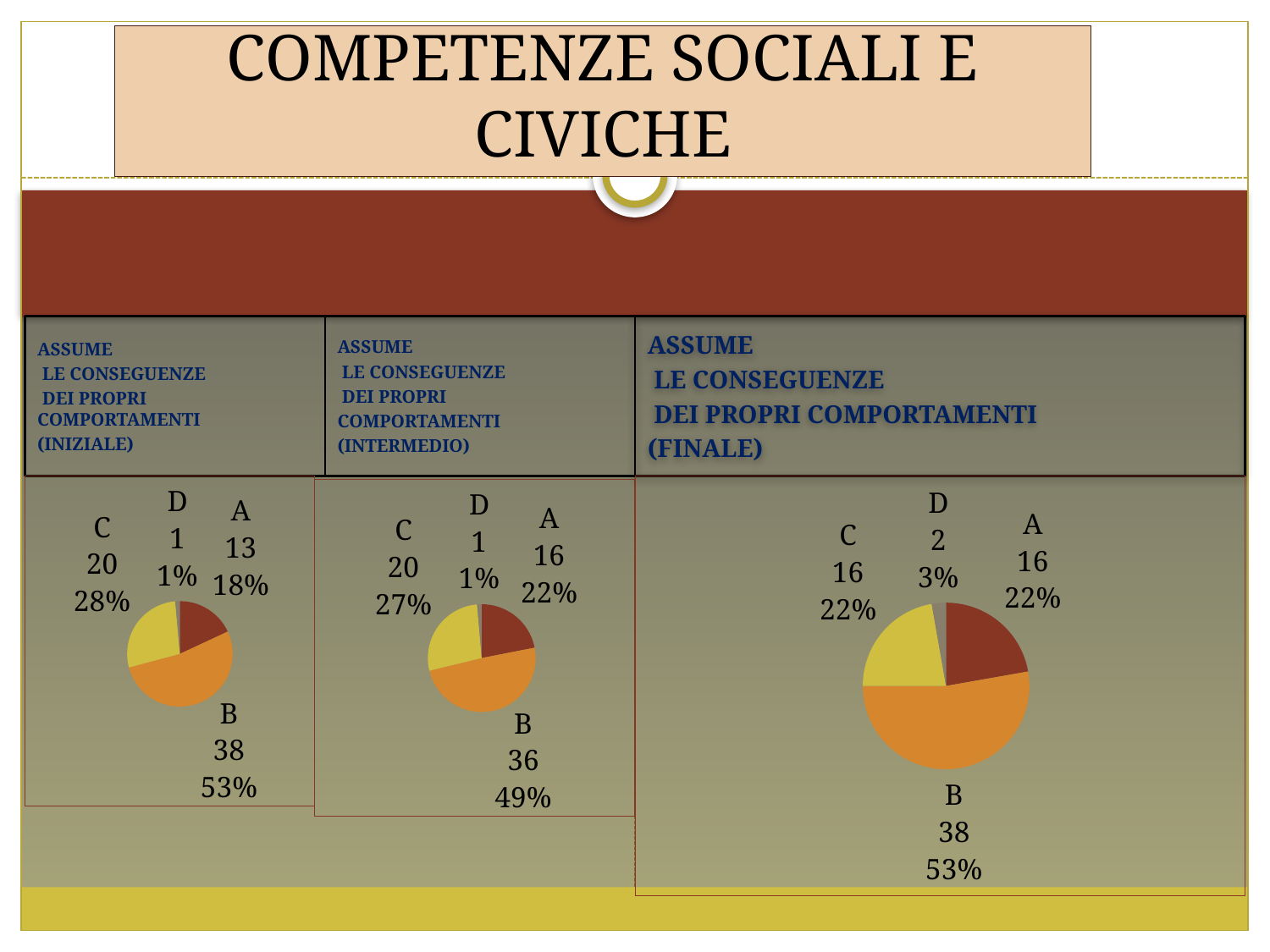
In the FINALE pie chart on the right, what is the value for category D? 2 In the FINALE pie chart on the right, what share of the pie does category B represent? 53% What type of chart is used in the INIZIALE panel on the left? pie chart In the INTERMEDIO pie chart in the middle, which category has the largest value? B In the INIZIALE pie chart on the left, which category has the smallest value? D In the INIZIALE pie chart on the left, what share of the pie does category C represent? 28% In the FINALE pie chart on the right, which is larger, the value for B or the value for C? B In the INTERMEDIO pie chart in the middle, what is the value for category A? 16 In the INTERMEDIO pie chart in the middle, what share of the pie does category B represent? 49% In the INTERMEDIO pie chart in the middle, what is the difference between the values for C and A? 4 In the FINALE pie chart on the right, how many categories are shown? 4 In the INIZIALE pie chart on the left, what is the value for category B? 38